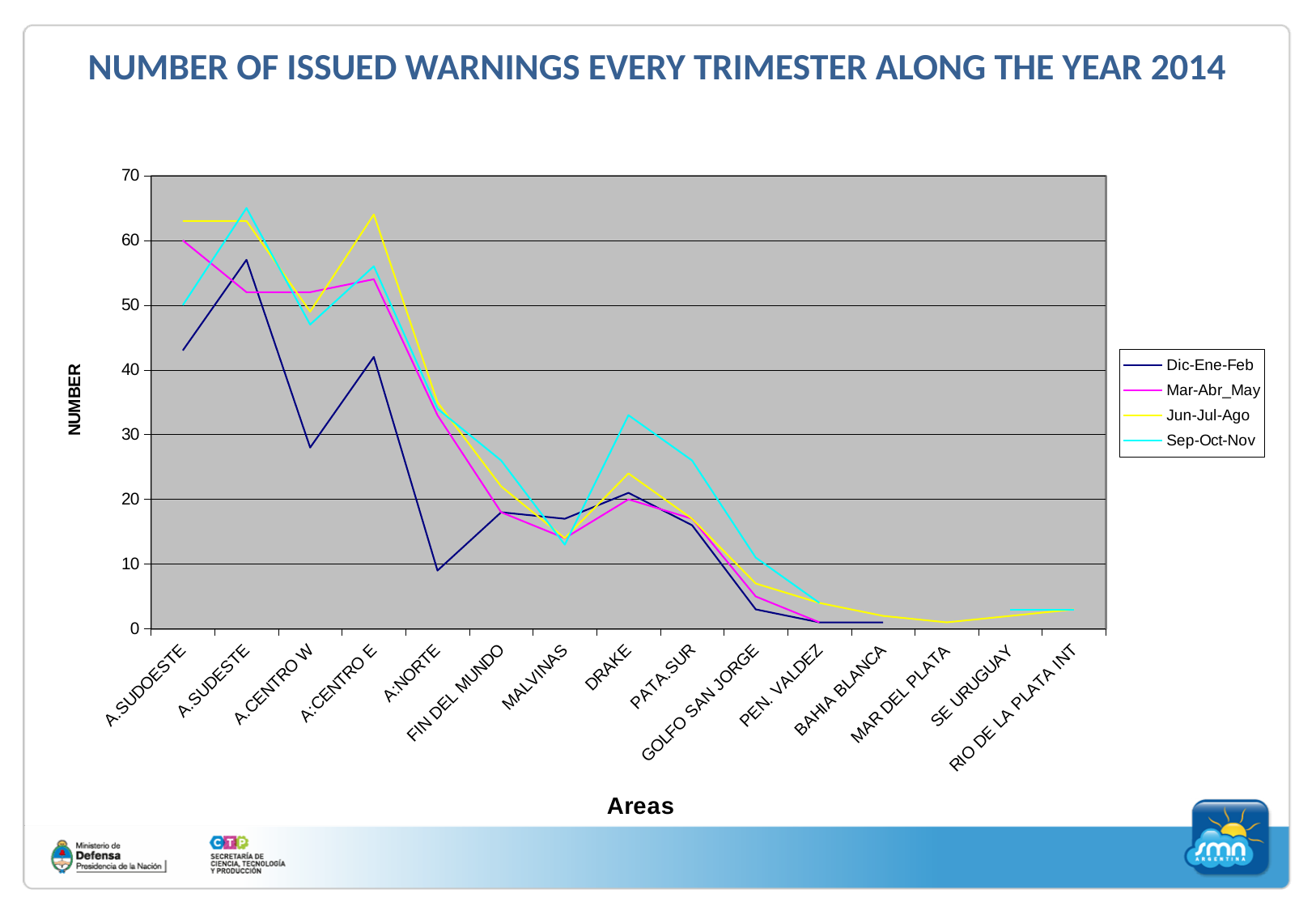
How many areas are shown along the x axis? 15 What is the title of the chart? NUMBER OF ISSUED WARNINGS EVERY TRIMESTER ALONG THE YEAR 2014 What kind of chart is shown on the slide? line chart What is the label of the x axis? Areas Is the Mar-Abr_May value for GOLFO SAN JORGE greater or less than 10? less Which series has the highest value at A:CENTRO E? Jun-Jul-Ago Is the Jun-Jul-Ago value for A:CENTRO E greater or less than 60? greater How many series does the legend list? 4 Which area has the highest Sep-Oct-Nov value? A.SUDESTE Does the Dic-Ene-Feb line rise or fall from A:CENTRO E to A:NORTE? fall At A:CENTRO W, which is larger: the Dic-Ene-Feb value or the Mar-Abr_May value? Mar-Abr_May Is the Dic-Ene-Feb value for A:NORTE greater or less than 20? less